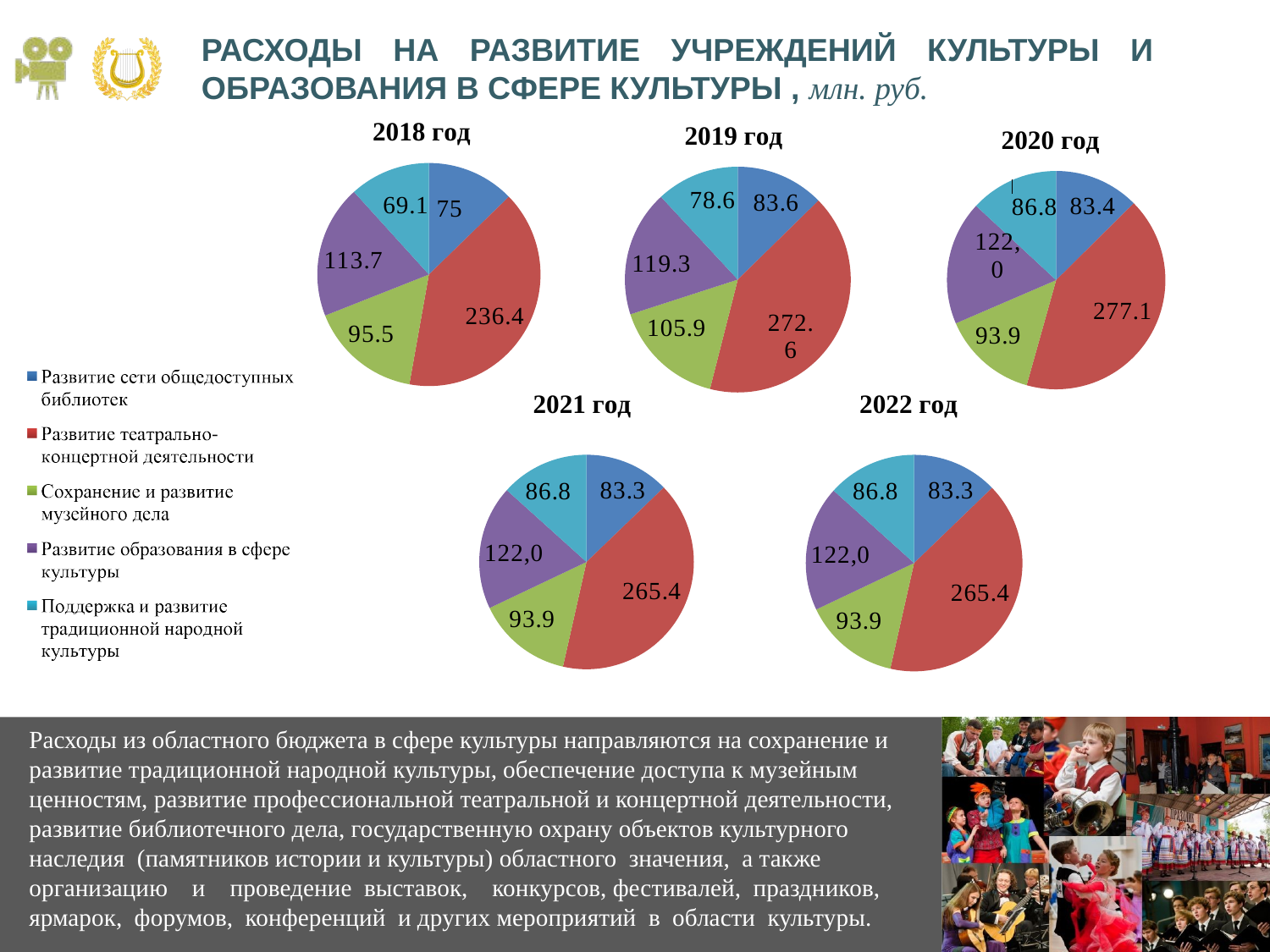
In the 2018 год pie chart, which category has the smallest value? Поддержка и развитие традиционной народной культуры In the 2020 год pie chart, what is the value for Развитие сети общедоступных библиотек? 83.4 What type of chart is used to show the 2021 год data? Pie chart How many categories does the legend list? 5 In the 2022 год pie chart, which category has the largest value? Развитие театрально-концертной деятельности In the 2019 год pie chart, what is the value for Сохранение и развитие музейного дела? 105.9 In the 2021 год pie chart, what is the value for Поддержка и развитие традиционной народной культуры? 86.8 In the 2018 год pie chart, what is the difference between Развитие театрально-концертной деятельности and Развитие сети общедоступных библиотек? 161.4 How many pie charts are shown on the slide? 5 In the 2018 год pie chart, what is the value for Развитие театрально-концертной деятельности? 236.4 In the 2020 год pie chart, which is larger: Развитие образования в сфере культуры or Сохранение и развитие музейного дела? Развитие образования в сфере культуры In the 2019 год pie chart, what is the difference between Развитие театрально-концертной деятельности and Поддержка и развитие традиционной народной культуры? 194